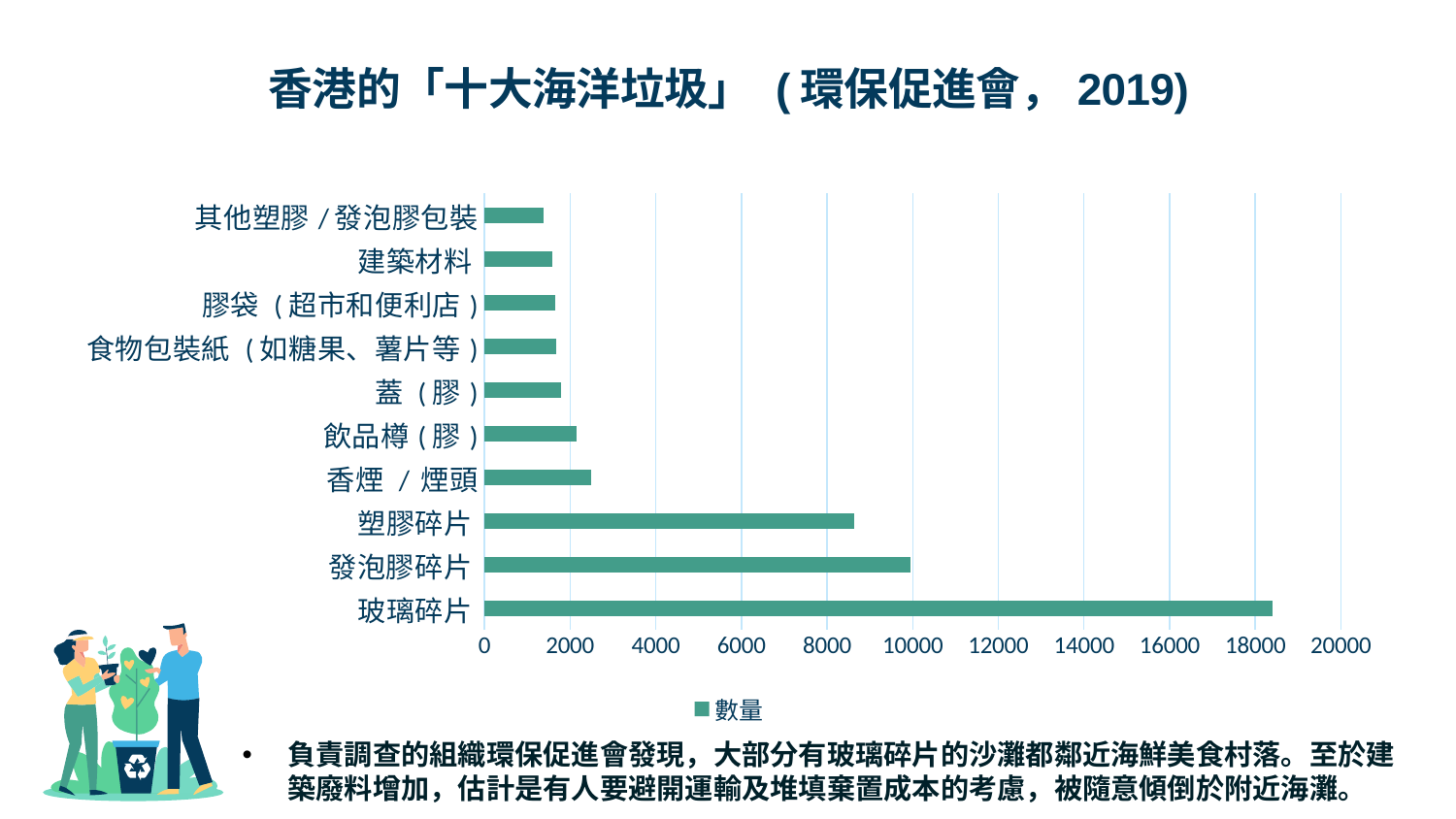
Is the value for 蓋（膠） greater or less than 2000? less What kind of chart is shown on the slide? bar chart Which category has the highest value in the chart? 玻璃碎片 Is the value for 塑膠碎片 greater or less than 8000? greater Which has the larger value, 香煙 / 煙頭 or 飲品樽 ( 膠 )? 香煙 / 煙頭 How many series does the legend list? 1 How many categories of marine litter are plotted in the chart? 10 Is the value for 香煙 / 煙頭 greater or less than 2000? greater Which has the larger value, 塑膠碎片 or 發泡膠碎片? 發泡膠碎片 What is the legend entry shown below the chart? 數量